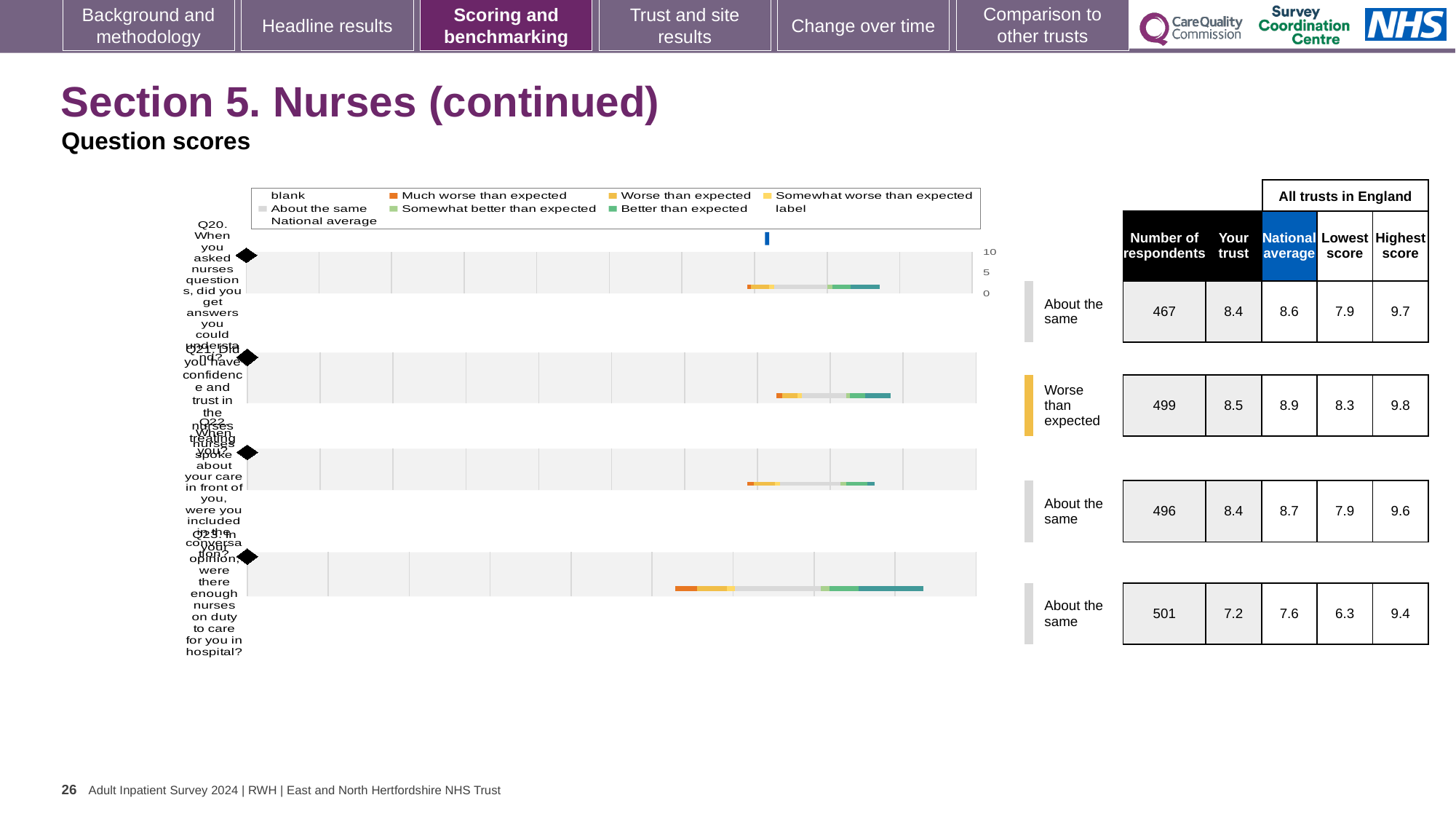
Which benchmark category is Q21 assigned to? Worse than expected What is the national average score for Q21 (confidence and trust in the nurses)? 8.9 What colour represents 'Much worse than expected' in the legend? Orange Which question has the highest 'Your trust' score? Q21 How many questions (rows) are plotted in the chart? 4 How many respondents answered Q20? 467 What is the 'Your trust' score for Q23 (enough nurses on duty)? 7.2 Which question has the lowest 'Your trust' score? Q23 For Q20, which is larger: the 'Your trust' score or the national average? National average For Q21, how much higher is the national average than the 'Your trust' score? 0.4 For Q23, what is the difference between the highest score and the lowest score across all trusts in England? 3.1 What kind of chart is shown on the slide? bar chart